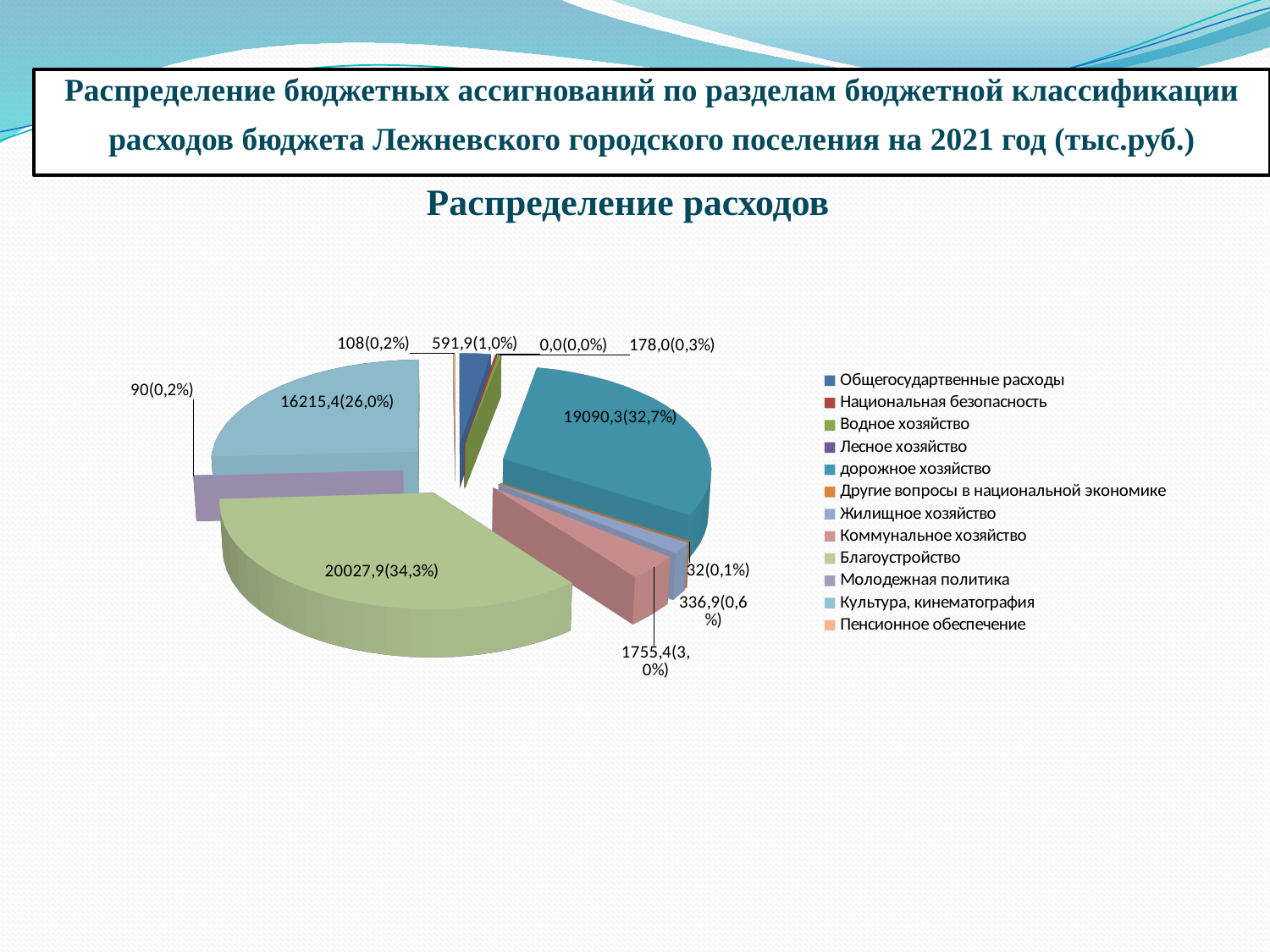
Which is larger, Благоустройство or дорожное хозяйство? Благоустройство What is the title of the chart? Распределение расходов Which category has the largest slice of the pie? Благоустройство What is the difference between the values for Благоустройство and дорожное хозяйство? 937,6 What value is shown for Культура, кинематография? 16215,4 What share of the pie does дорожное хозяйство take? 32,7% What kind of chart is shown on the slide? pie chart What value is shown for Благоустройство? 20027,9 What value is shown for дорожное хозяйство? 19090,3 What is the difference between the values for дорожное хозяйство and Культура, кинематография? 2874,9 What share of the pie does Благоустройство take? 34,3% How many categories does the chart legend list? 12